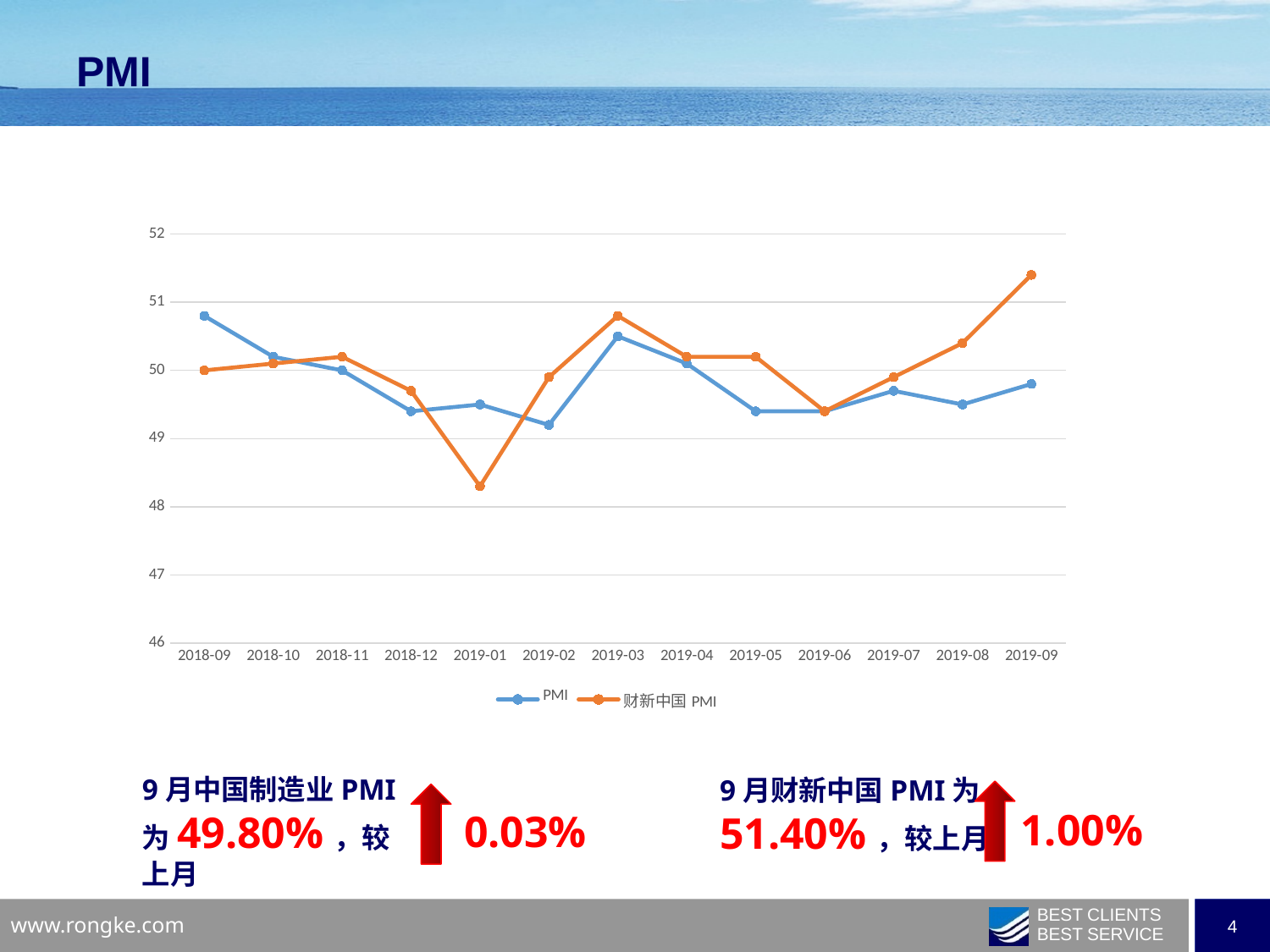
What is the value of 财新中国 PMI for 2019-09? 51.40% How many months are plotted along the x axis? 13 What kind of chart is shown on the slide? line chart Is the value of 财新中国 PMI for 2019-01 greater or less than 49? less How many series does the legend list? 2 In which month is 财新中国 PMI at its lowest? 2019-01 In which month is 财新中国 PMI at its highest? 2019-09 What is the value of PMI for 2019-09? 49.80% Does 财新中国 PMI rise or fall from 2019-06 to 2019-09? rise Is the value of PMI for 2018-09 greater or less than 50? greater Which series has the higher value in 2019-01, PMI or 财新中国 PMI? PMI Which colour is used for the 财新中国 PMI line? orange